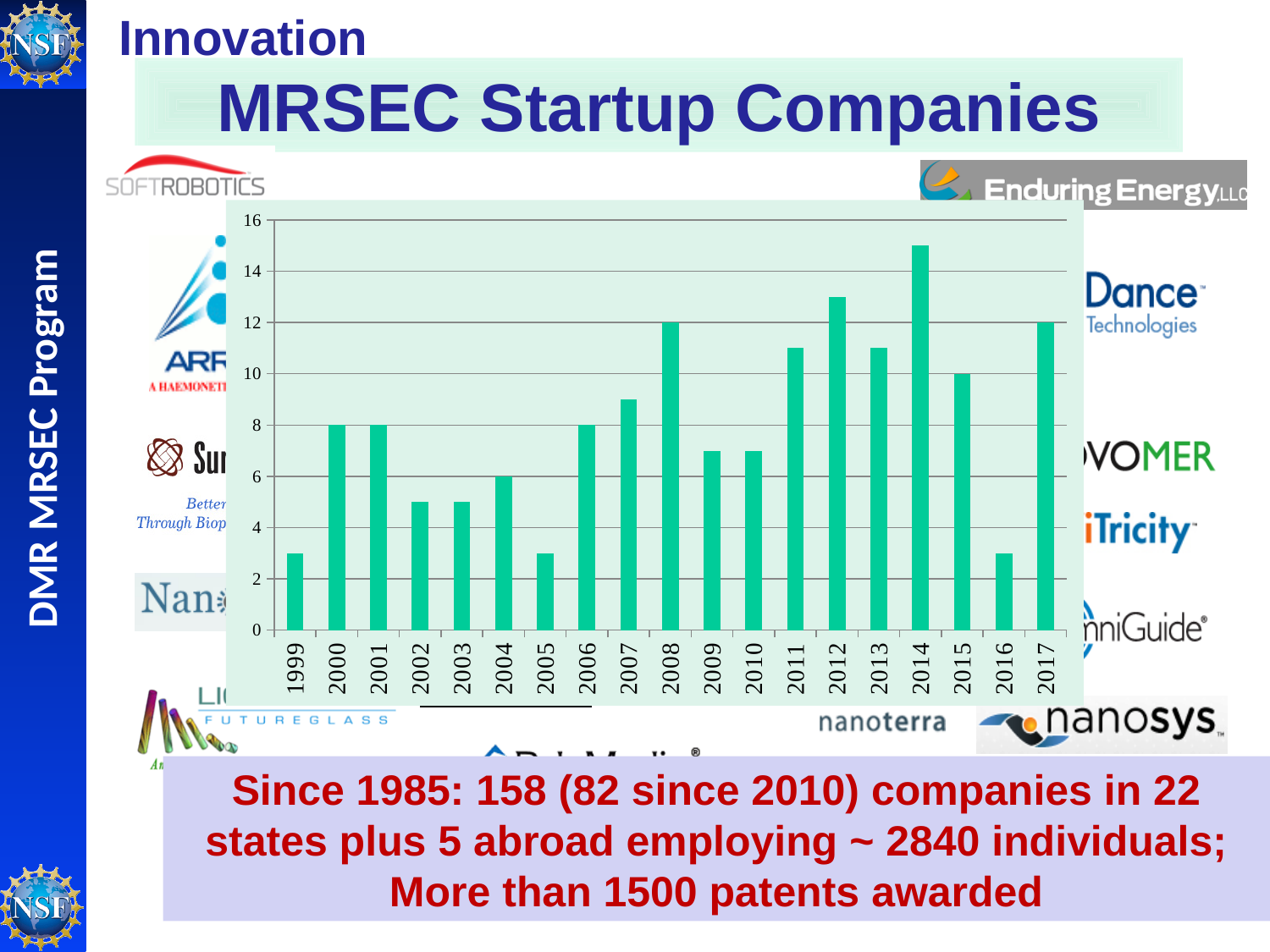
Is the value for 1999 greater or less than 4? less How many years are shown on the x axis of the chart? 19 What kind of chart is shown on the slide? bar chart What is the value for 2000? 8 Which year has the highest bar in the chart? 2014 Is the value for 2014 greater or less than 14? greater What is the value for 2015? 10 What is the value for 2004? 6 Which is larger, the value for 2012 or the value for 2013? 2012 Does the value rise or fall from 2015 to 2016? fall What is the value for 2008? 12 What is the difference between the values for 2008 and 2004? 6